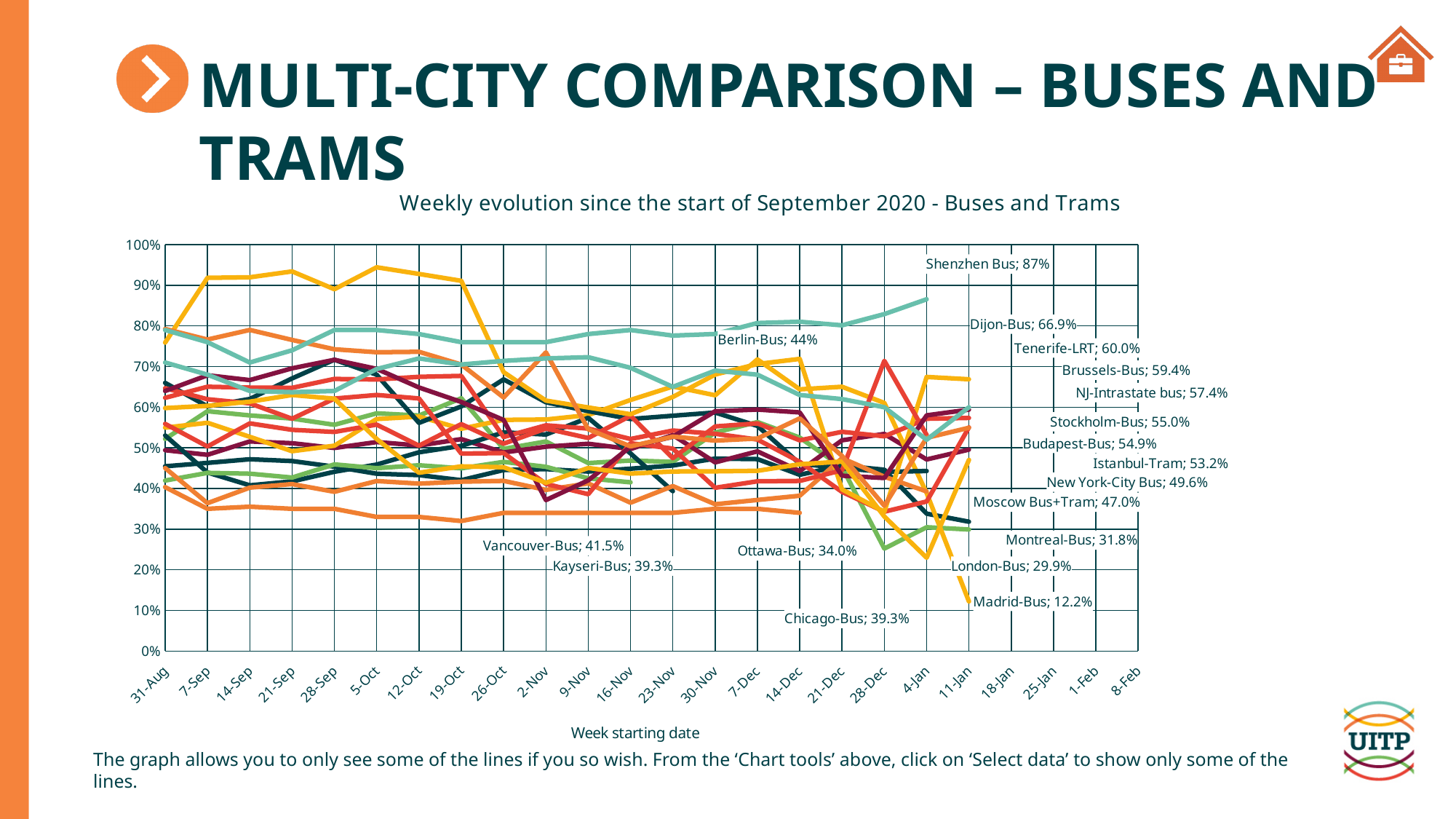
What is the labelled value for Madrid-Bus? 12.2% What is the labelled value for Dijon-Bus? 66.9% What is the labelled value for Shenzhen Bus? 87% Which labelled series has the lowest value? Madrid-Bus What is the title of the chart? Weekly evolution since the start of September 2020 - Buses and Trams Which labelled series has the highest value? Shenzhen Bus What is the labelled value for Istanbul-Tram? 53.2% What is the difference between the labelled values for Dijon-Bus and Tenerife-LRT? 6.9% What kind of chart is shown on the slide? Line chart Which has the larger labelled value, Montreal-Bus or London-Bus? Montreal-Bus What is the difference between the labelled values for Shenzhen Bus and Madrid-Bus? 74.8% How many week starting dates are shown on the x axis? 24